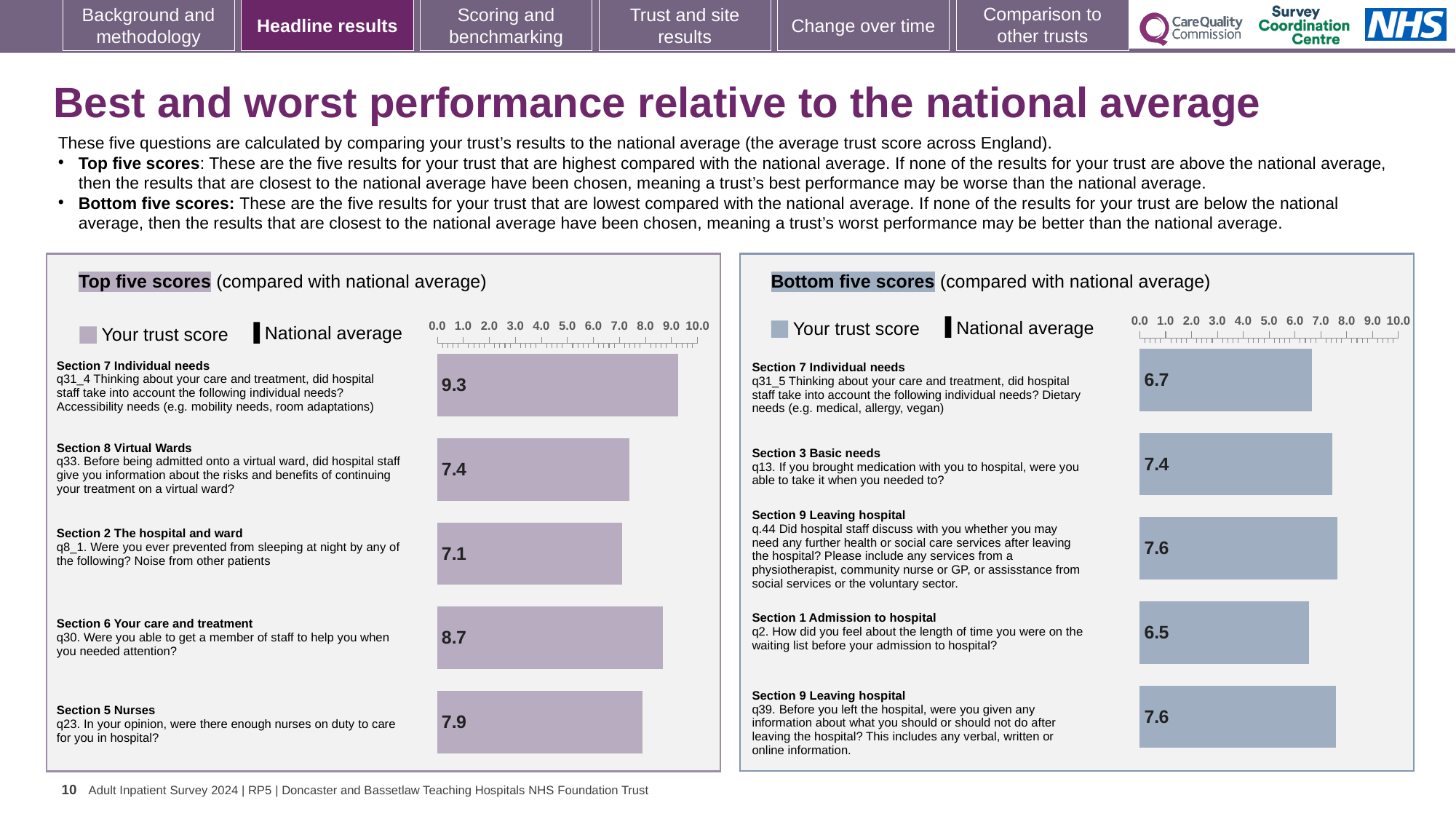
In the Bottom five scores chart, which question has the lowest trust score? q2 length of time on the waiting list (Section 1 Admission to hospital) In the Bottom five scores chart, what is the trust score for q2 (length of time on the waiting list)? 6.5 In the Top five scores chart, what is the trust score for q31_4 (Accessibility needs)? 9.3 How many bars are shown in the Top five scores chart? 5 In the Top five scores chart, which question has the highest trust score? q31_4 Accessibility needs (Section 7 Individual needs) In the Bottom five scores chart, what is the trust score for q13 (able to take medication when needed)? 7.4 In the Bottom five scores chart, is the trust score for q31_5 (Dietary needs) larger or smaller than the score for q13? smaller In the Top five scores chart, what is the difference between the trust scores for q31_4 and q30? 0.6 What type of chart is used for the Bottom five scores? Bar chart In the Top five scores chart, what is the trust score for q23 (enough nurses on duty)? 7.9 In the Bottom five scores chart, what is the difference between the trust scores for q.44 and q2? 1.1 In the Top five scores chart, which question has the lowest trust score? q8_1 Noise from other patients (Section 2 The hospital and ward)